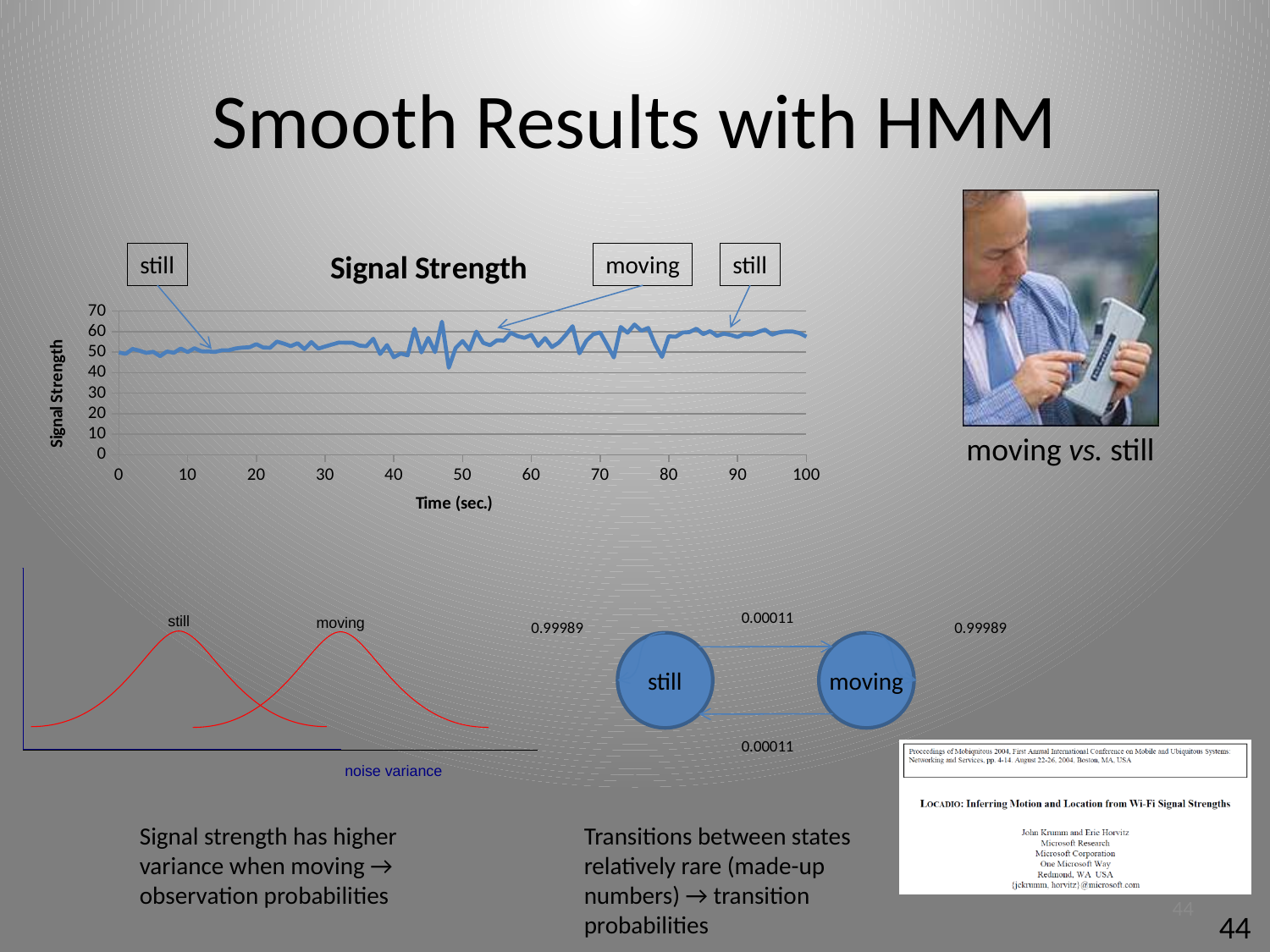
In the lower-left diagram of two curves, which curve is centered at the higher noise variance, still or moving? moving What is the x-axis title of the Signal Strength chart? Time (sec.) What kind of chart is the Signal Strength chart? line chart In the Signal Strength chart, is the value at time 50 greater or less than 20? greater What is the title of the line chart at the top of the slide? Signal Strength In the Signal Strength chart, is the value at time 100 greater or less than 40? greater In the Signal Strength chart, is the value at time 20 greater or less than 70? less